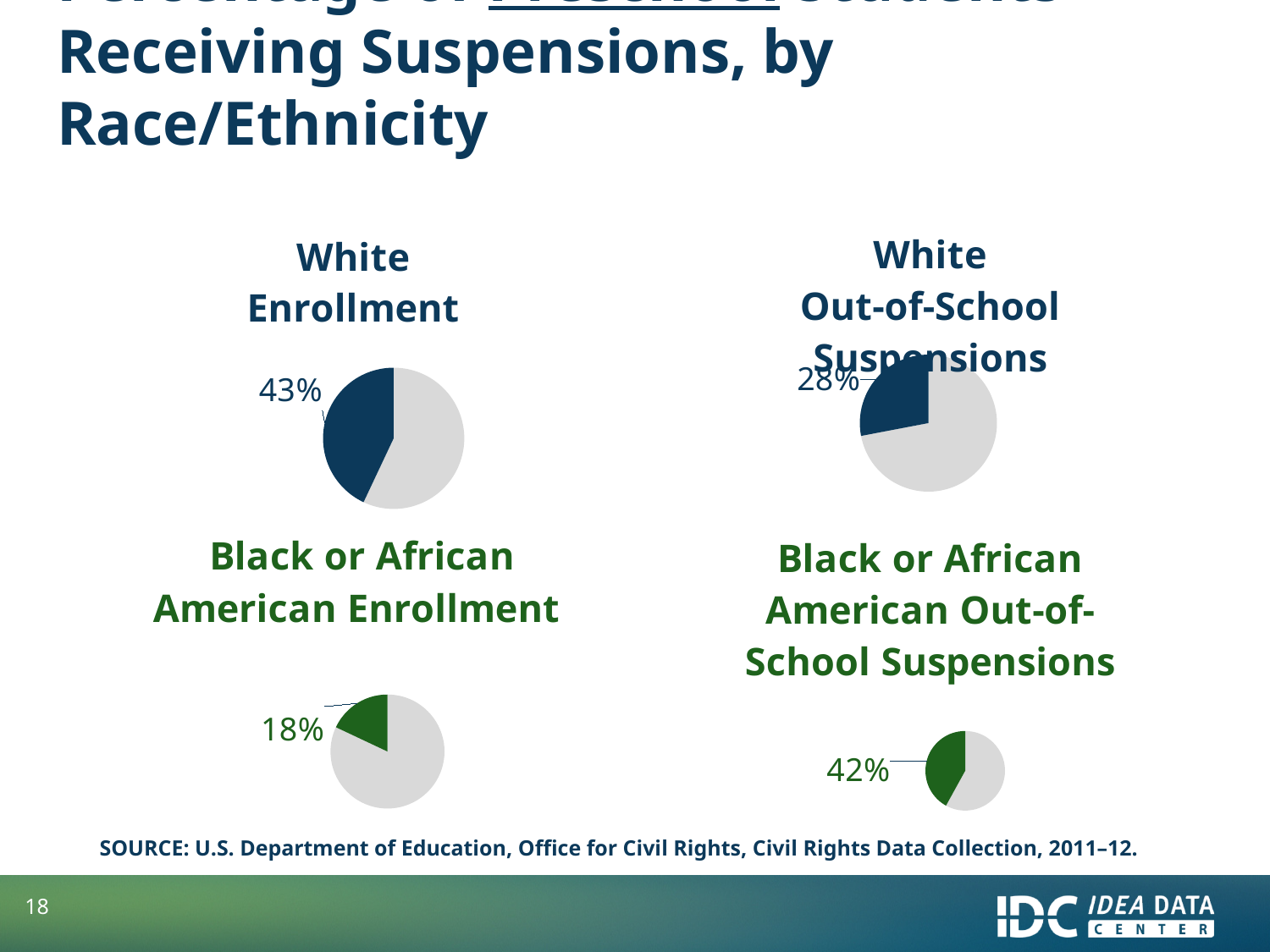
In the Black or African American Enrollment chart, what percentage does the highlighted slice show? 18% What colour is the labeled slice in the Black or African American Enrollment chart? Green What is the difference between the labeled share in the Black or African American Out-of-School Suspensions chart and the labeled share in the Black or African American Enrollment chart? 24% What kind of chart is the White Enrollment chart? Pie chart Across the four pie charts, which chart has the smallest labeled share? Black or African American Enrollment In the White Enrollment chart, what percentage does the highlighted slice show? 43% In the Black or African American Out-of-School Suspensions chart, what percentage does the highlighted slice show? 42% In the White Out-of-School Suspensions chart, what percentage does the highlighted slice show? 28% How many pie charts are shown on the slide? 4 Which is larger: the labeled share in the White Enrollment chart or the labeled share in the White Out-of-School Suspensions chart? White Enrollment Which is larger: the labeled share in the Black or African American Enrollment chart or the labeled share in the Black or African American Out-of-School Suspensions chart? Black or African American Out-of-School Suspensions What is the difference between the labeled share in the White Enrollment chart and the labeled share in the White Out-of-School Suspensions chart? 15%